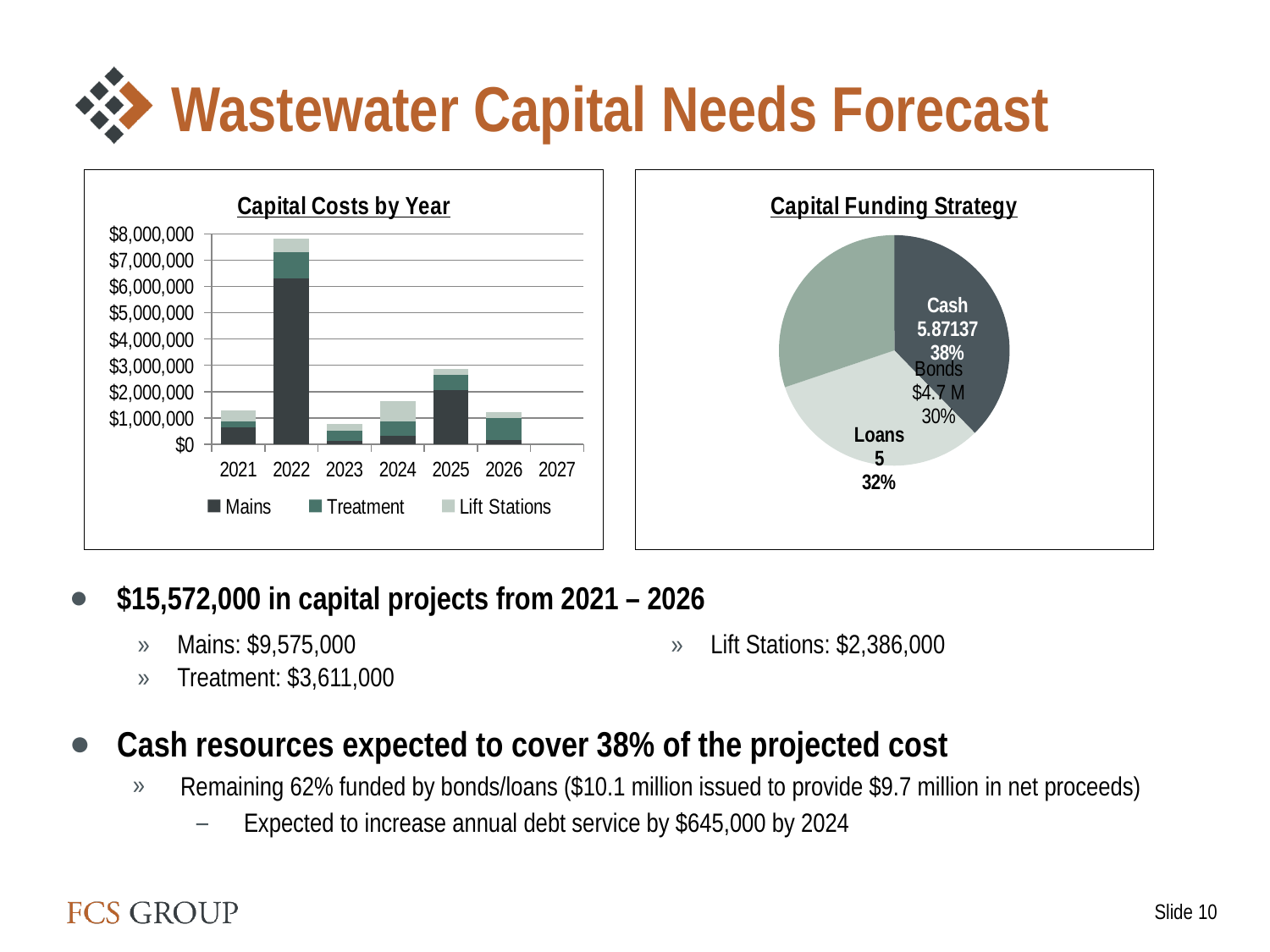
What kind of chart is the 'Capital Costs by Year' chart? Stacked bar chart What kind of chart is the 'Capital Funding Strategy' chart? Pie chart In the 'Capital Funding Strategy' chart, what share of funding comes from Cash? 38% In the 'Capital Costs by Year' chart, which year has the larger total, 2022 or 2025? 2022 In the 'Capital Costs by Year' chart, how many series does the legend list? 3 In the 'Capital Funding Strategy' chart, which funding source has the smallest slice? Bonds In the 'Capital Costs by Year' chart, what are the three series listed in the legend? Mains, Treatment, Lift Stations In the 'Capital Funding Strategy' chart, what share of funding comes from Loans? 32% In the 'Capital Costs by Year' chart, is the total for 2023 greater or less than $1,000,000? less In the 'Capital Costs by Year' chart, is the total for 2022 greater or less than $7,000,000? greater In the 'Capital Costs by Year' chart, which year has the highest total capital cost? 2022 In the 'Capital Costs by Year' chart, how many years are shown on the x axis? 7